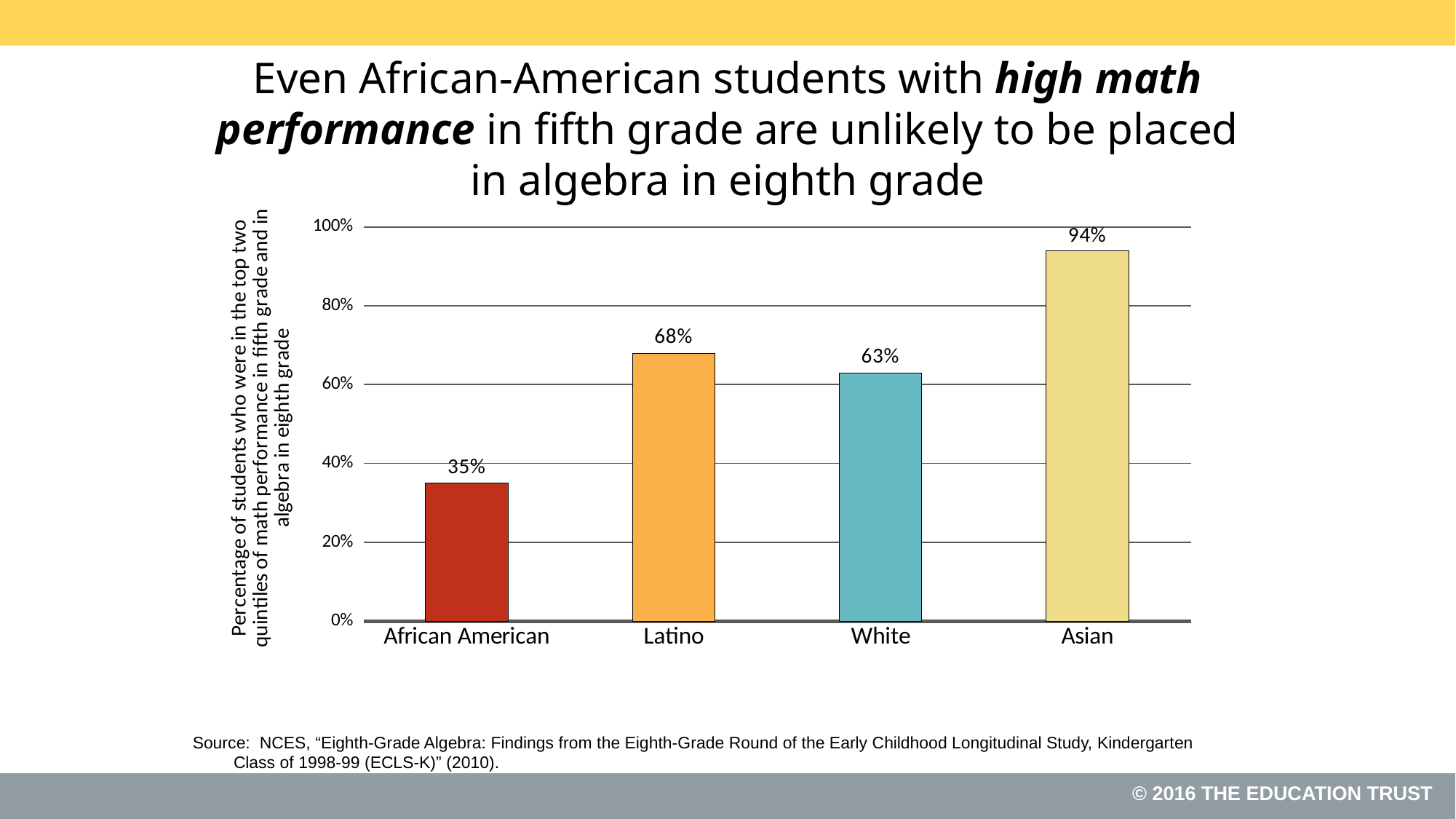
What is the difference between the values for Asian and African American students? 59% Which is larger, the value for Latino or the value for White? Latino What kind of chart is shown on the slide? bar chart What is the value for Asian students? 94% How many categories are shown on the x axis? 4 Is the value for African American students greater or less than 40%? less Which category has the lowest value? African American What is the difference between the values for Latino and White students? 5% Which category has the highest value? Asian What is the value for African American students? 35% What is the value for White students? 63% What is the value for Latino students? 68%